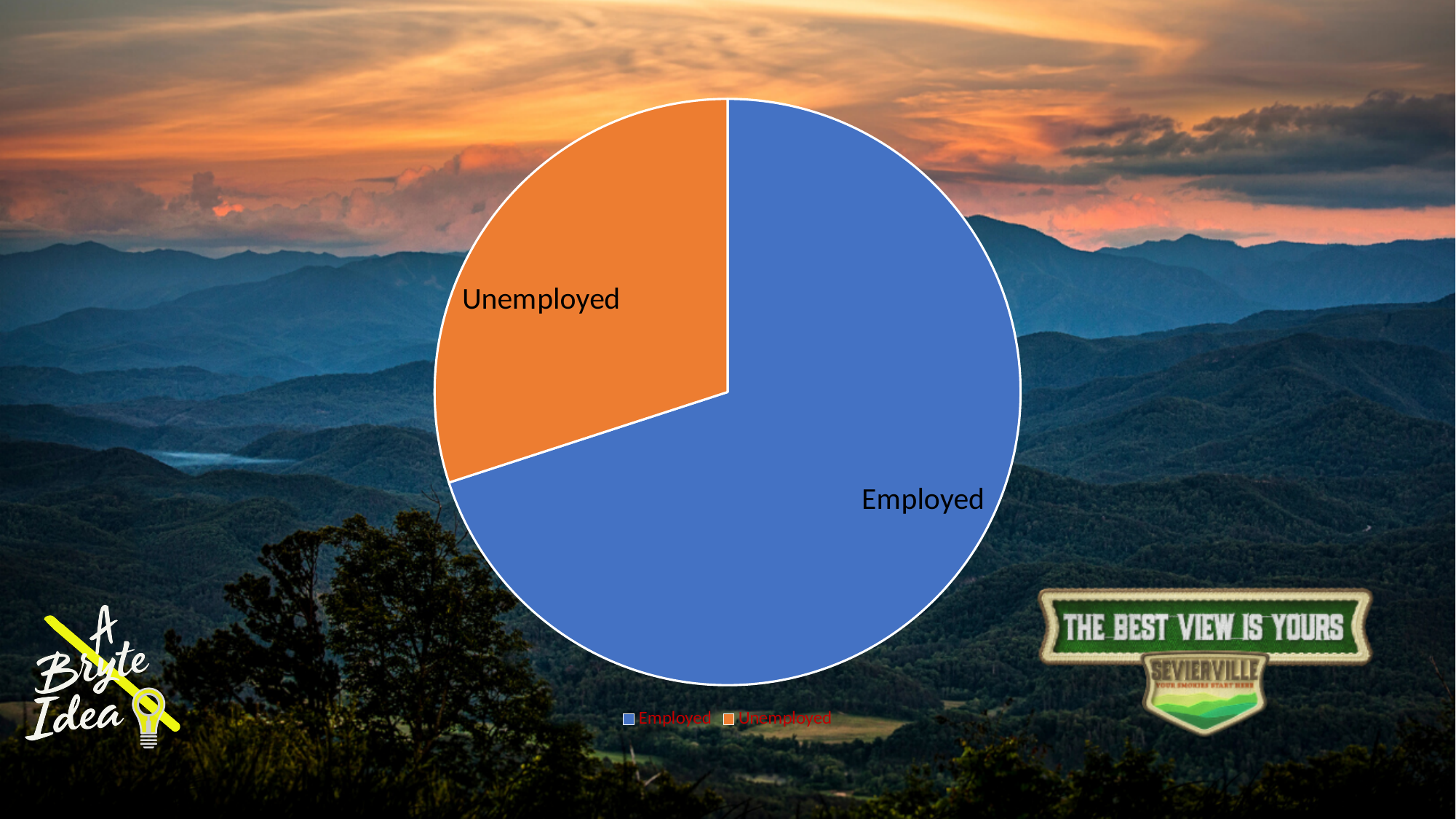
What colour is the Unemployed slice in the pie chart? orange How many entries does the legend of the pie chart list? 2 Which slice of the pie chart is the smallest? Unemployed Which slice is larger in the pie chart, Employed or Unemployed? Employed How many slices does the pie chart have? 2 What kind of chart is shown on the slide? pie chart What colour is the Employed slice in the pie chart? blue Which slice of the pie chart is the largest? Employed